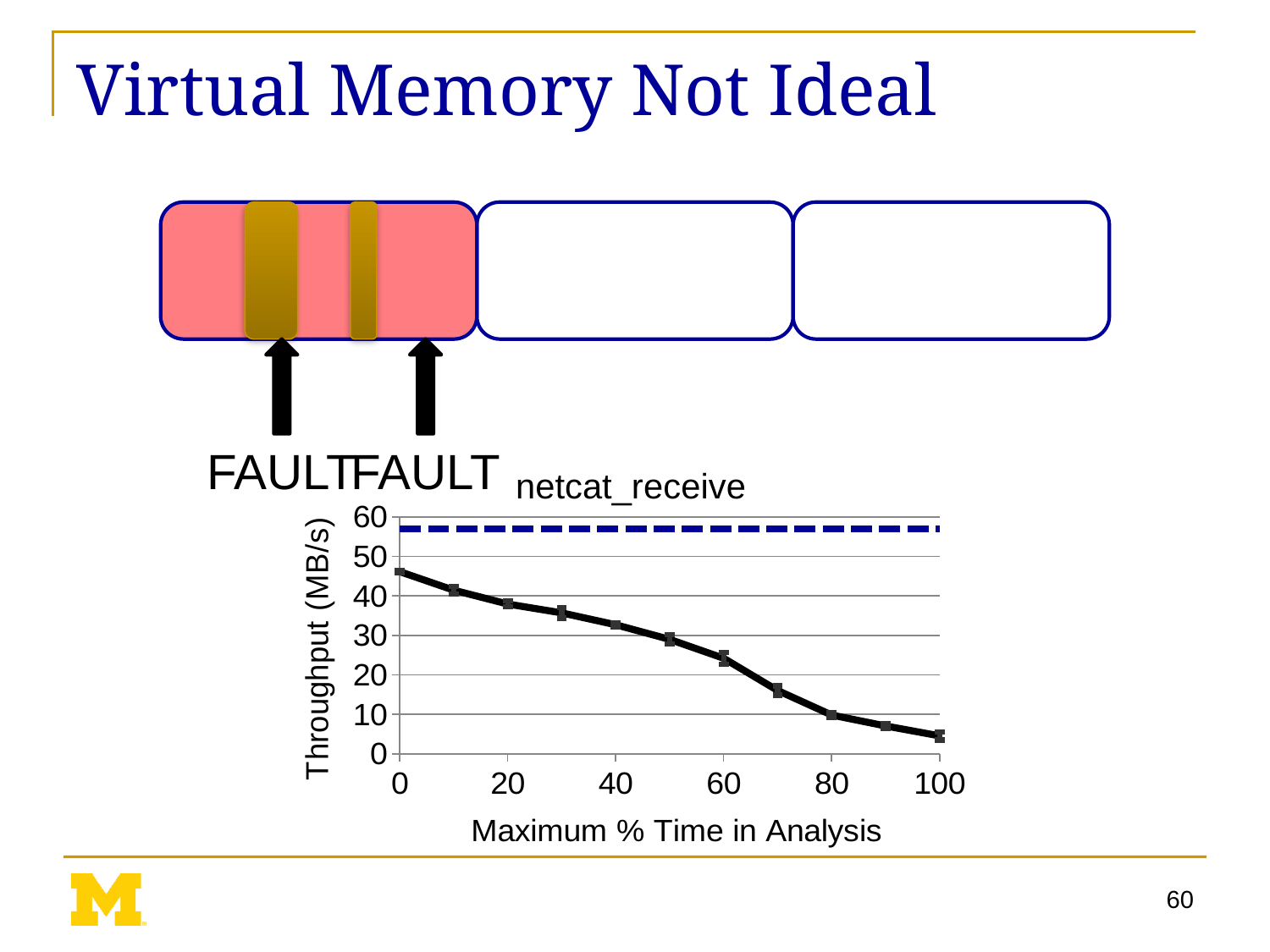
At which Maximum % Time in Analysis value is throughput lowest? 100 Is the throughput at 100% Maximum Time in Analysis greater or less than 10 MB/s? less Is the throughput at 0% Maximum Time in Analysis greater or less than 40 MB/s? greater What kind of chart is shown on the slide? line chart Which has higher throughput: 20% or 80% Maximum Time in Analysis? 20% At which Maximum % Time in Analysis value is throughput highest? 0 What is the title of the chart? netcat_receive Is the throughput at 60% Maximum Time in Analysis greater or less than 30 MB/s? less Does throughput rise or fall as Maximum % Time in Analysis increases from 0 to 100? fall How many data points are plotted on the solid line? 11 What is the label of the y axis of the chart? Throughput (MB/s)